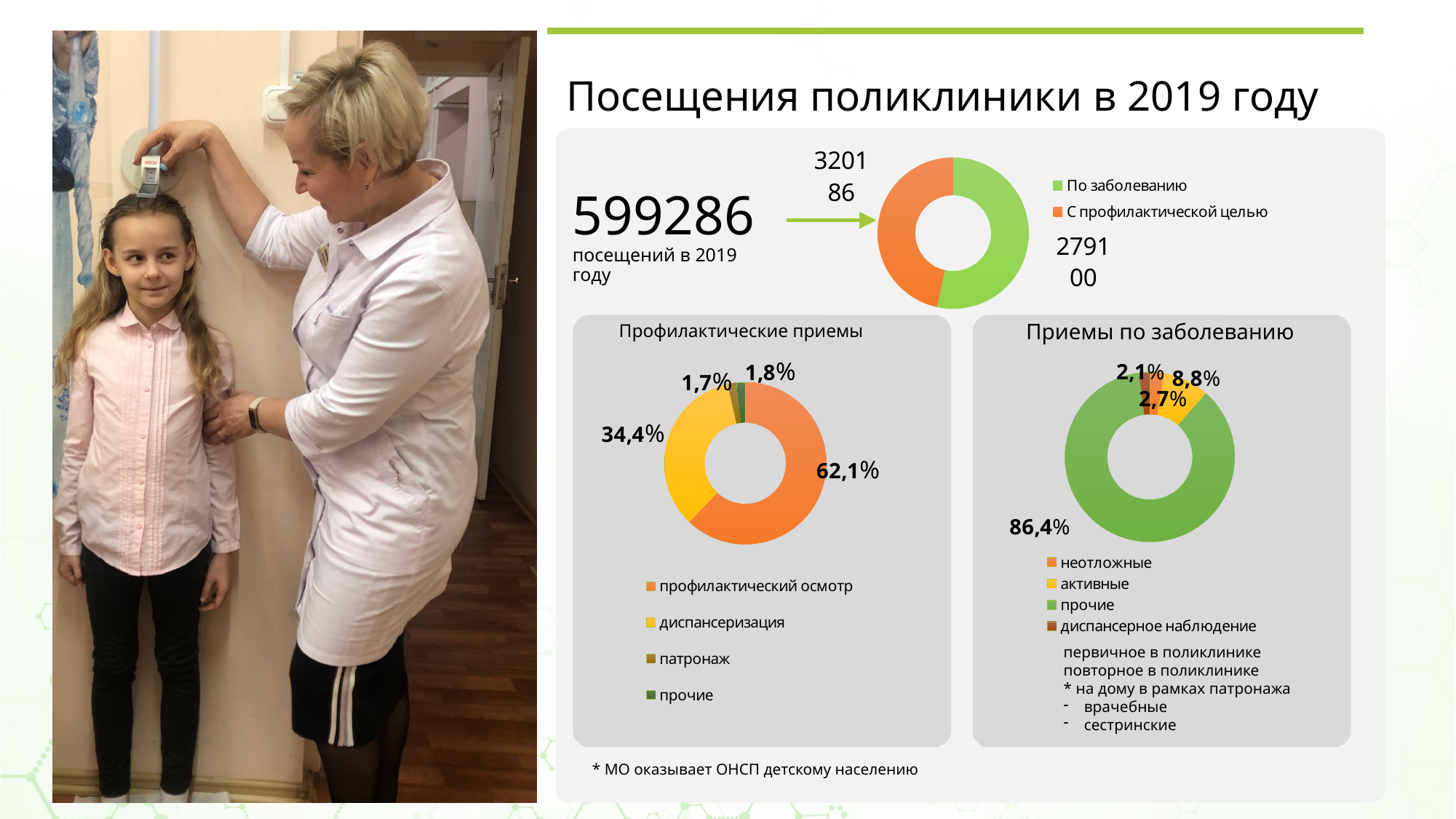
What kind of chart is 'Профилактические приемы'? Donut (pie) chart How many entries does the legend of the 'Профилактические приемы' chart list? 4 What is the title of the slide containing the charts? Посещения поликлиники в 2019 году In the 'Профилактические приемы' chart, what is the difference between 'профилактический осмотр' and 'диспансеризация'? 27,7% In the 'Приемы по заболеванию' chart, what share is 'активные'? 8,8% How many entries does the legend of the top donut chart list? 2 In the 'Профилактические приемы' chart, which category has the largest share? профилактический осмотр In the 'Приемы по заболеванию' chart, which category has the largest share? прочие In the 'Профилактические приемы' chart, what share is 'профилактический осмотр'? 62,1% In the 'Приемы по заболеванию' chart, which is larger: 'активные' or 'прочие'? прочие In the 'Профилактические приемы' chart, what share is 'диспансеризация'? 34,4% In the 'Приемы по заболеванию' chart, what share is 'прочие'? 86,4%